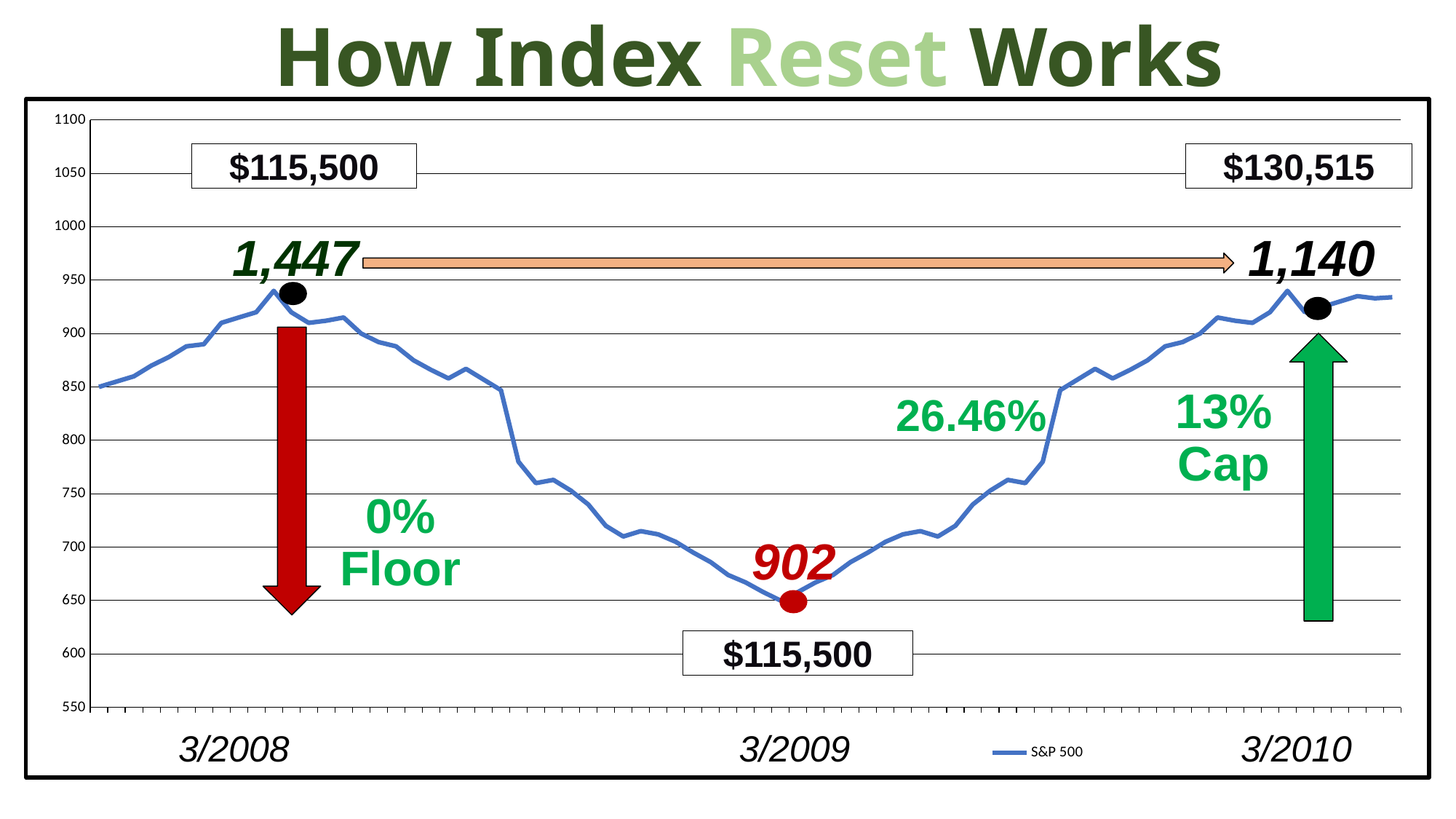
What index value is labelled at 3/2008 on the chart? 1,447 What percentage is labelled next to the rise between 3/2009 and 3/2010? 26.46% Is the plotted S&P 500 value at 3/2009 greater or less than 700? less What index value is labelled at 3/2009 on the chart? 902 What dollar amount is shown in the box below the 3/2009 point? $115,500 What dollar amount is shown in the box above the 3/2010 point? $130,515 Which of the three labelled dates has the lowest labelled index value? 3/2009 What index value is labelled at 3/2010 on the chart? 1,140 How many series does the legend list? 1 What series does the legend list for the chart? S&P 500 What type of chart is shown on the slide? line chart Does the S&P 500 line rise or fall between 3/2008 and 3/2009? fall